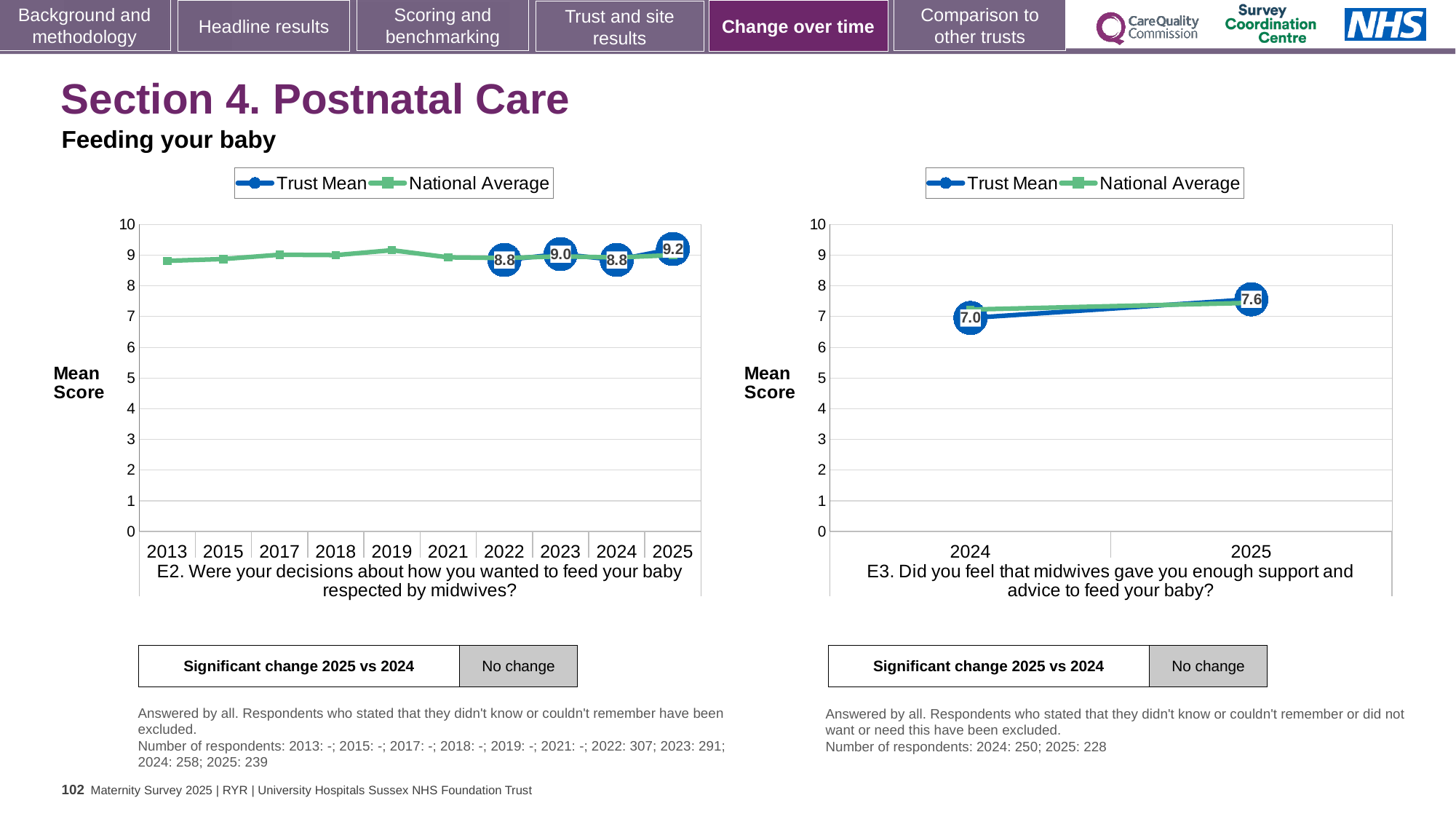
In the E2 chart (left), what is the difference between the Trust Mean for 2025 and 2024? 0.4 In the E3 chart (right), what is the Trust Mean for 2025? 7.6 In the E2 chart (left), which year has the highest labelled Trust Mean? 2025 In the E2 chart (left), what is the Trust Mean for 2022? 8.8 In the E2 chart (left), what is the Trust Mean for 2025? 9.2 What kind of chart is the E2 chart (left)? line chart In the E2 chart (left), how many years are shown on the x axis? 10 In the E3 chart (right), what is the difference between the Trust Mean for 2025 and 2024? 0.6 In the E2 chart (left), what is the Trust Mean for 2023? 9.0 In the E3 chart (right), how many series does the legend list? 2 In the E3 chart (right), what is the Trust Mean for 2024? 7.0 In the E3 chart (right), does the Trust Mean rise or fall from 2024 to 2025? rise